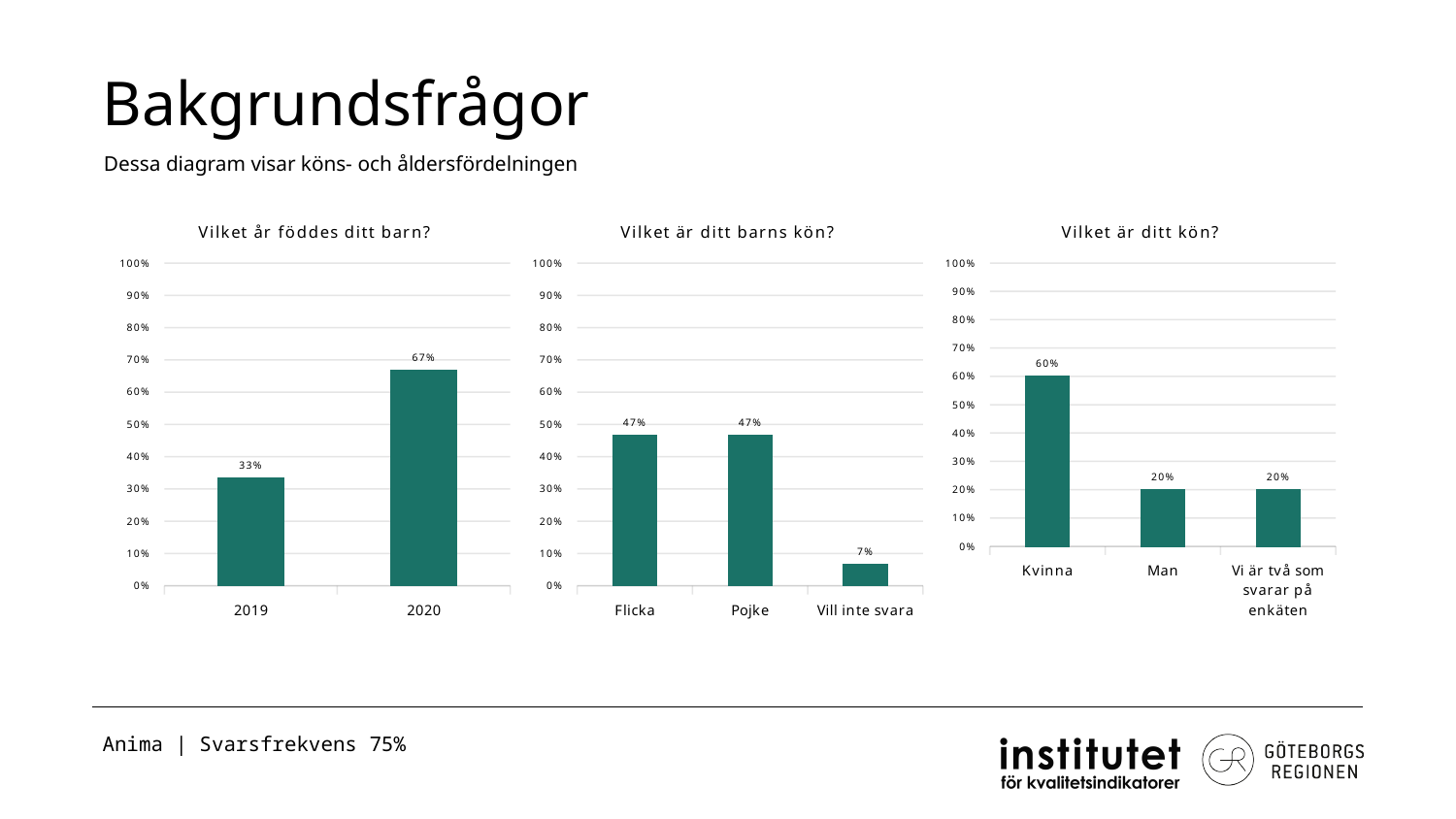
What kind of chart is 'Vilket år föddes ditt barn?'? Bar chart In the chart 'Vilket år föddes ditt barn?', what is the value for 2020? 67% In the chart 'Vilket är ditt kön?', what is the value for Kvinna? 60% In the chart 'Vilket är ditt barns kön?', how many categories are shown? 3 In the chart 'Vilket år föddes ditt barn?', what is the difference between the values for 2020 and 2019? 34% In the chart 'Vilket är ditt barns kön?', what is the value for Flicka? 47% In the chart 'Vilket är ditt kön?', which category has the highest value? Kvinna In the chart 'Vilket är ditt barns kön?', which category has the lowest value? Vill inte svara In the chart 'Vilket är ditt kön?', is the value for Kvinna greater or less than 50%? greater In the chart 'Vilket är ditt kön?', what is the difference between the values for Kvinna and Man? 40% In the chart 'Vilket år föddes ditt barn?', what is the value for 2019? 33% In the chart 'Vilket är ditt barns kön?', what is the value for Vill inte svara? 7%